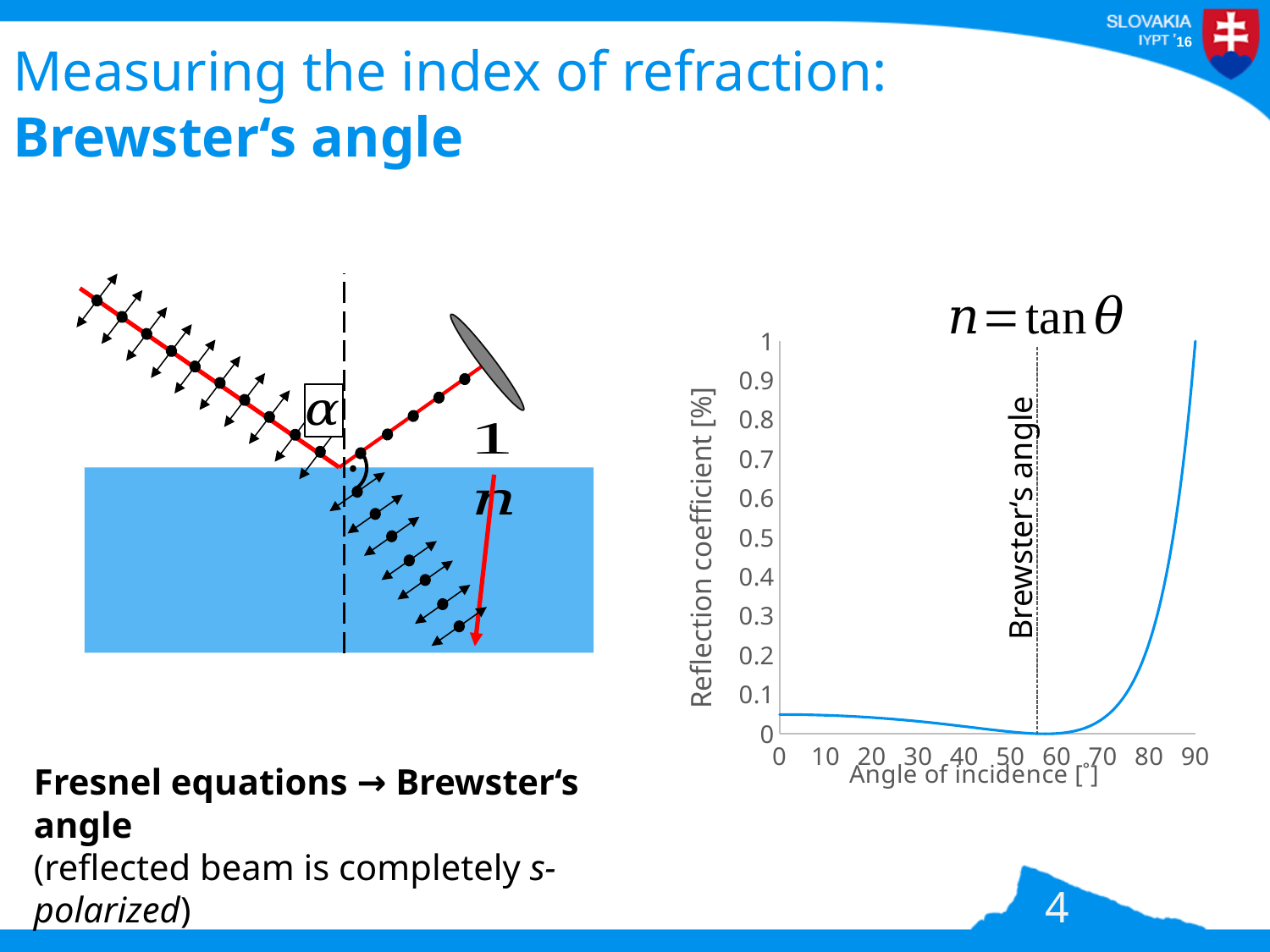
What is the reflection coefficient at an angle of incidence of 90°? 1 At which marked angle does the reflection coefficient reach its minimum? Brewster's angle What does the vertical dashed line in the chart mark? Brewster's angle Is the reflection coefficient at an angle of incidence of 60° greater or less than 0.1? less What is the label of the vertical axis of the chart? Reflection coefficient [%] Which has the larger reflection coefficient: an angle of incidence of 0° or 90°? 90° What is the highest value shown on the vertical axis of the chart? 1 Does the reflection coefficient rise or fall as the angle of incidence increases from Brewster's angle to 90°? rise Is the reflection coefficient at an angle of incidence of 80° greater or less than 0.5? less What kind of chart is shown on the right of the slide? line chart Is the reflection coefficient at an angle of incidence of 0° greater or less than 0.1? less At which angle of incidence does the reflection coefficient reach its maximum? 90